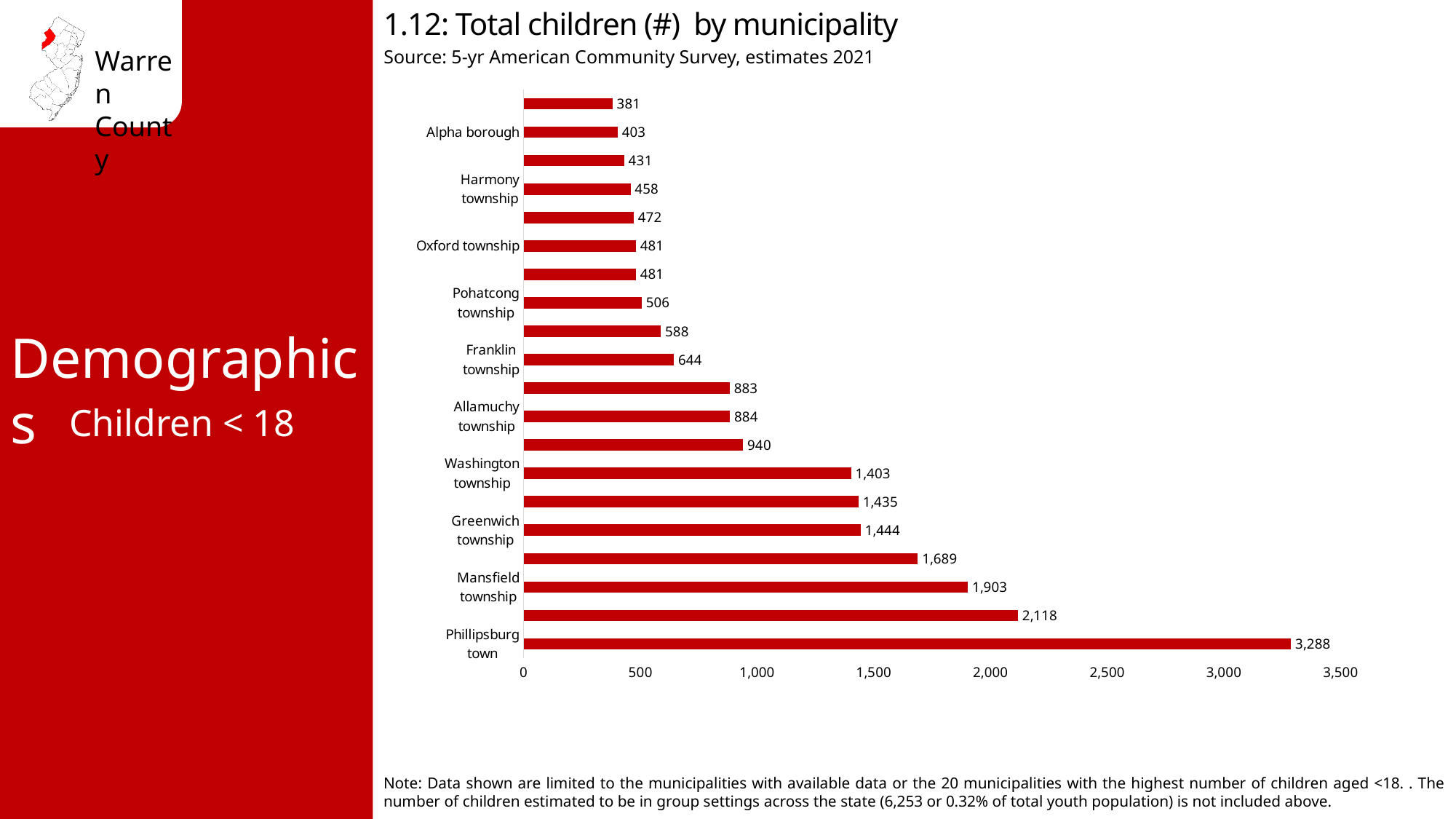
What is the smallest value shown on the chart? 381 Which is larger, Pohatcong township or Oxford township? Pohatcong township Is the value for Allamuchy township greater or less than 1,000? less How many bars are shown on the chart? 20 What is the value for Mansfield township? 1,903 Which municipality has the highest number of children? Phillipsburg town What is the value for Phillipsburg town? 3,288 What is the value for Alpha borough? 403 What is the value for Franklin township? 644 What kind of chart is shown on the slide? Bar chart What is the difference between Phillipsburg town and Mansfield township? 1,385 What is the difference between Greenwich township and Washington township? 41